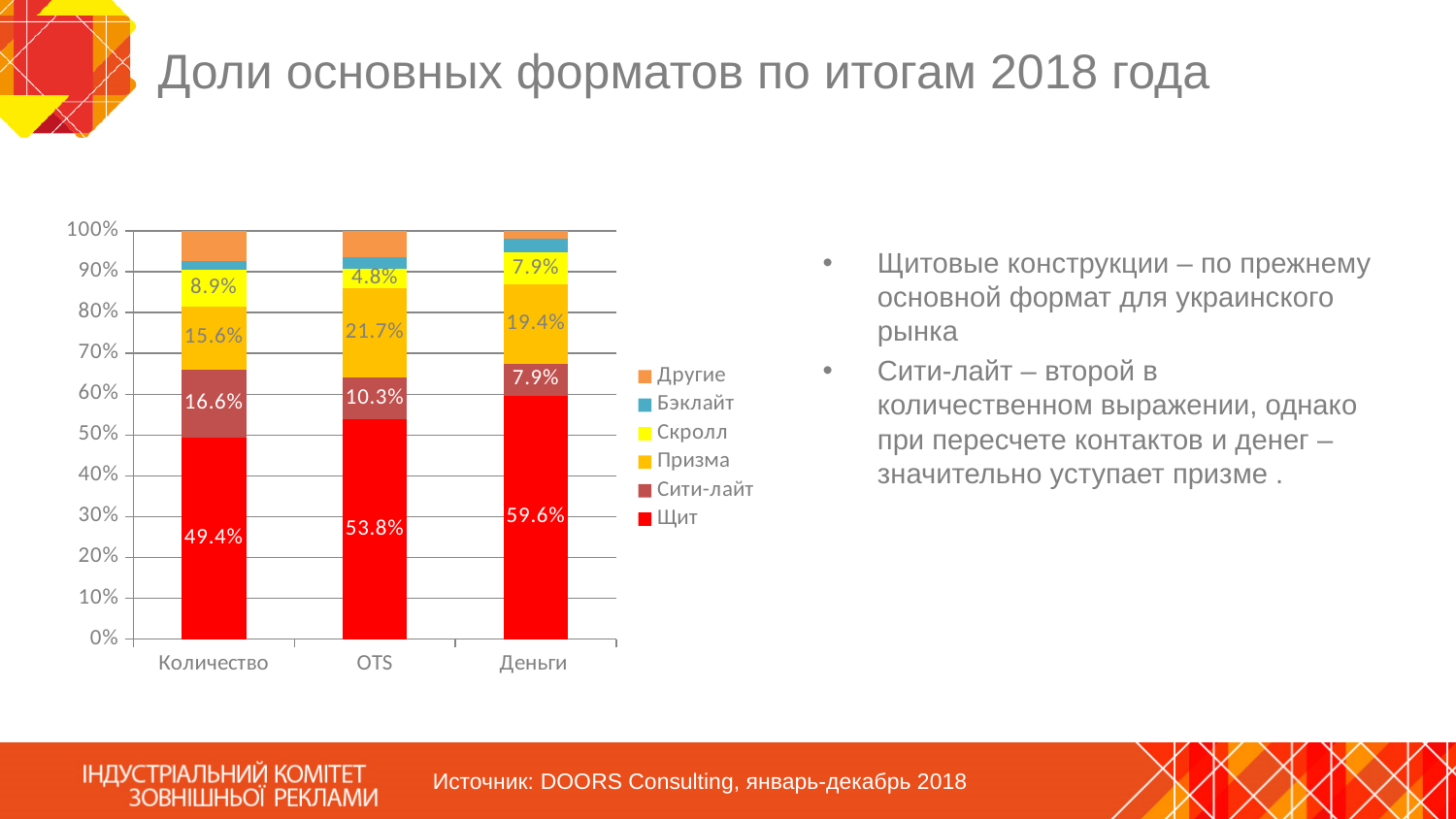
What is the value of Сити-лайт for Деньги? 7.9% What is the value of Призма for OTS? 21.7% In which category is the Щит share highest? Деньги Which is larger for OTS: the Призма share or the Сити-лайт share? Призма What kind of chart is shown on the slide? Stacked bar chart What is the value of Скролл for Количество? 8.9% What is the value of Щит for Количество? 49.4% What is the difference between the Щит share for Деньги and for Количество? 10.2% How many series does the legend list? 6 How many categories are shown on the x axis? 3 Does the Сити-лайт share rise or fall from Количество to Деньги? Fall In which category is the Скролл share lowest? OTS